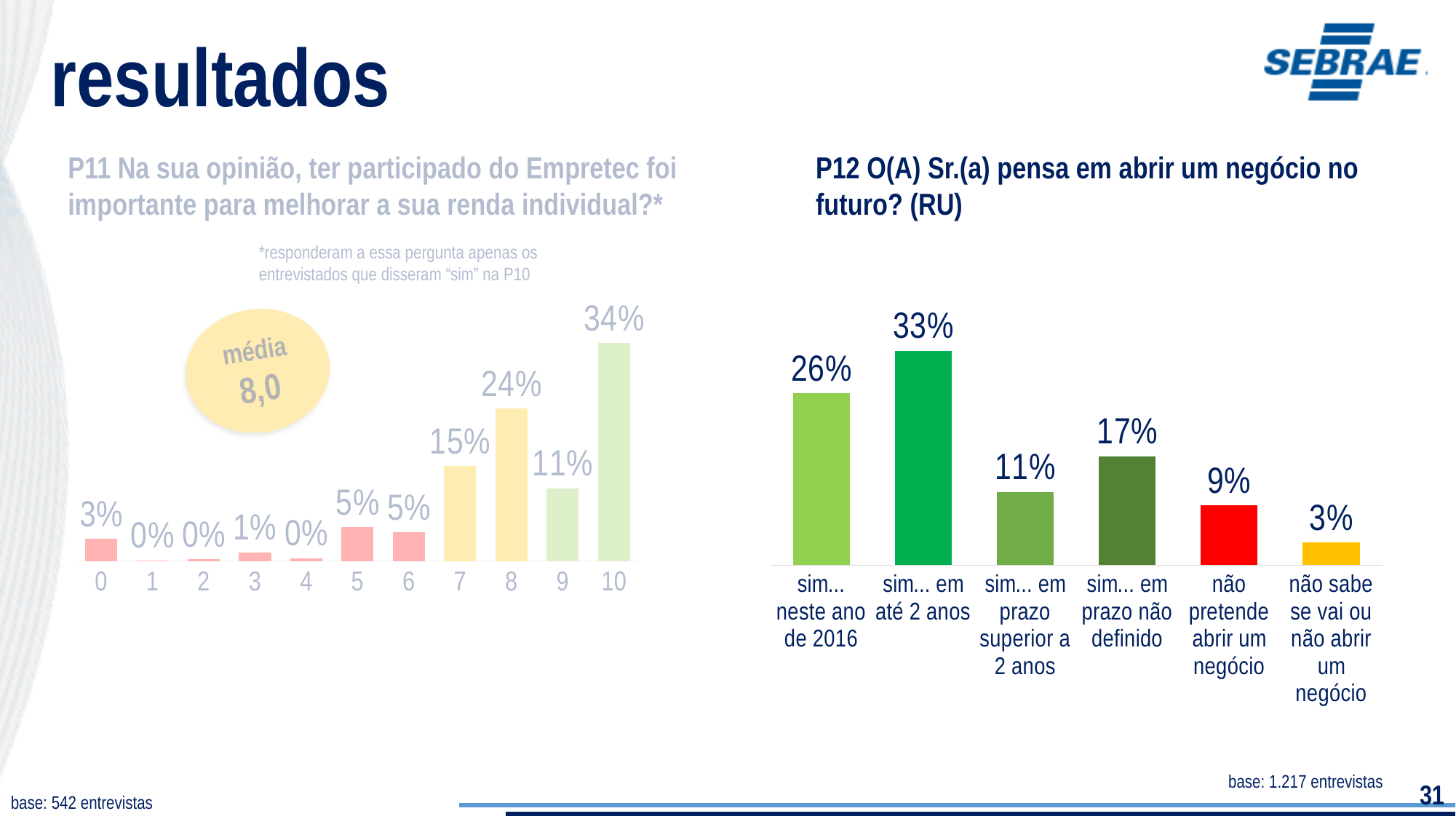
What average (média) is shown in the bubble on the P11 chart on the left? 8,0 In the P12 chart on the right, what is the difference between "sim... neste ano de 2016" and "sim... em prazo não definido"? 9% In the P12 chart on the right, what is the value for "não pretende abrir um negócio"? 9% In the P12 chart on the right, which is larger: "sim... em prazo superior a 2 anos" or "sim... em prazo não definido"? sim... em prazo não definido What type of chart is the P12 chart on the right? bar chart In the P11 chart on the left, what is the difference between the values for score 10 and score 9? 23% In the P12 chart on the right, which category has the highest value? sim... em até 2 anos In the P12 chart on the right, what percentage of respondents answered "sim... em até 2 anos"? 33% In the P11 chart on the left, what is the value for score 10? 34% How many categories are shown in the P12 chart on the right? 6 In the P12 chart on the right, which category has the lowest value? não sabe se vai ou não abrir um negócio In the P11 chart on the left, what is the value for score 8? 24%